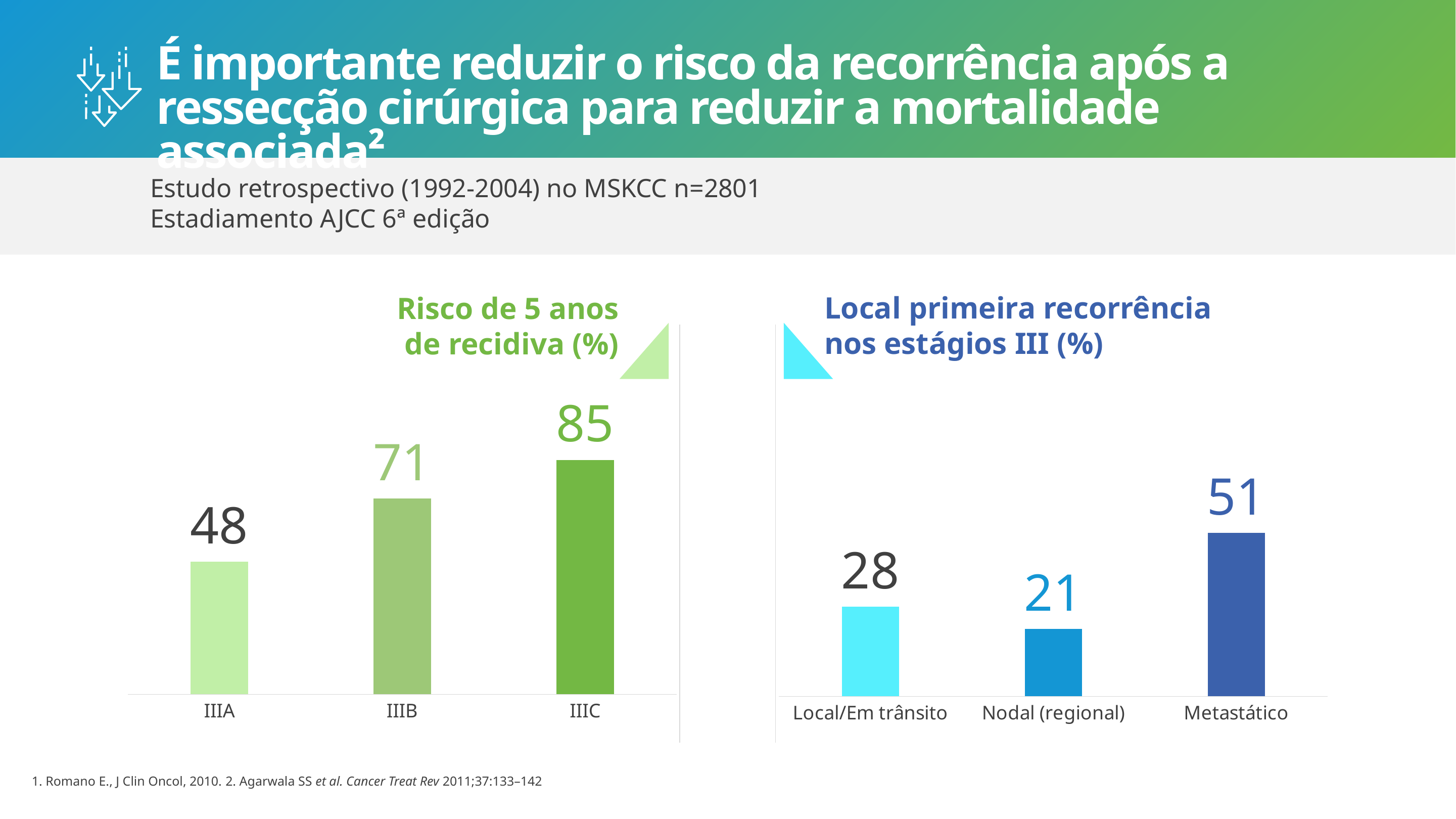
In the 'Risco de 5 anos de recidiva (%)' chart, which stage has the lowest value? IIIA In the 'Risco de 5 anos de recidiva (%)' chart, what is the difference between the values for IIIC and IIIA? 37 In the 'Local primeira recorrência nos estágios III (%)' chart, which is larger: Local/Em trânsito or Nodal (regional)? Local/Em trânsito In the 'Risco de 5 anos de recidiva (%)' chart, what is the value for IIIA? 48 In the 'Risco de 5 anos de recidiva (%)' chart, which stage has the highest value? IIIC In the 'Local primeira recorrência nos estágios III (%)' chart, what is the difference between Metastático and Local/Em trânsito? 23 In the 'Local primeira recorrência nos estágios III (%)' chart, what is the value for Metastático? 51 How many categories are shown in the 'Local primeira recorrência nos estágios III (%)' chart? 3 In the 'Local primeira recorrência nos estágios III (%)' chart, what is the value for Nodal (regional)? 21 In the 'Local primeira recorrência nos estágios III (%)' chart, which category has the lowest value? Nodal (regional) In the 'Risco de 5 anos de recidiva (%)' chart, what is the value for IIIB? 71 In the 'Risco de 5 anos de recidiva (%)' chart, do the values rise or fall from IIIA to IIIC? rise